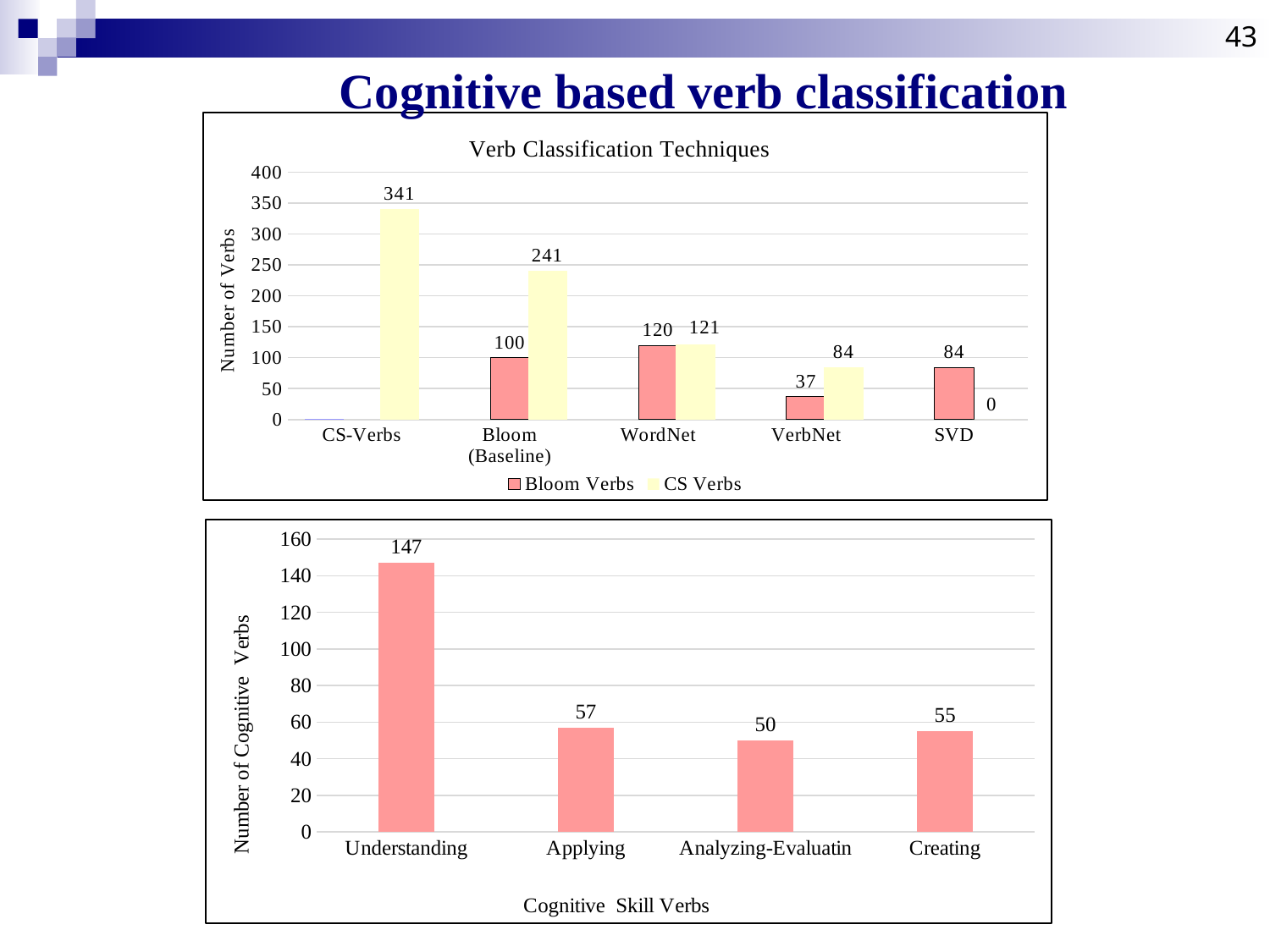
In the bottom chart, which category has the lowest value? Analyzing-Evaluatin In the bottom chart, what is the value for Understanding? 147 In the 'Verb Classification Techniques' chart, what is the CS Verbs value for CS-Verbs? 341 In the 'Verb Classification Techniques' chart, what is the difference between the CS Verbs values for Bloom (Baseline) and VerbNet? 157 In the 'Verb Classification Techniques' chart, how many series does the legend list? 2 In the 'Verb Classification Techniques' chart, which is larger for VerbNet: Bloom Verbs or CS Verbs? CS Verbs In the 'Verb Classification Techniques' chart, what is the Bloom Verbs value for WordNet? 120 In the 'Verb Classification Techniques' chart, which category has the highest Bloom Verbs value? WordNet In the bottom chart, how many categories are shown on the x axis? 4 In the 'Verb Classification Techniques' chart, what is the CS Verbs value for SVD? 0 What kind of chart is the bottom chart? Bar chart In the bottom chart, what is the difference between the values for Applying and Creating? 2